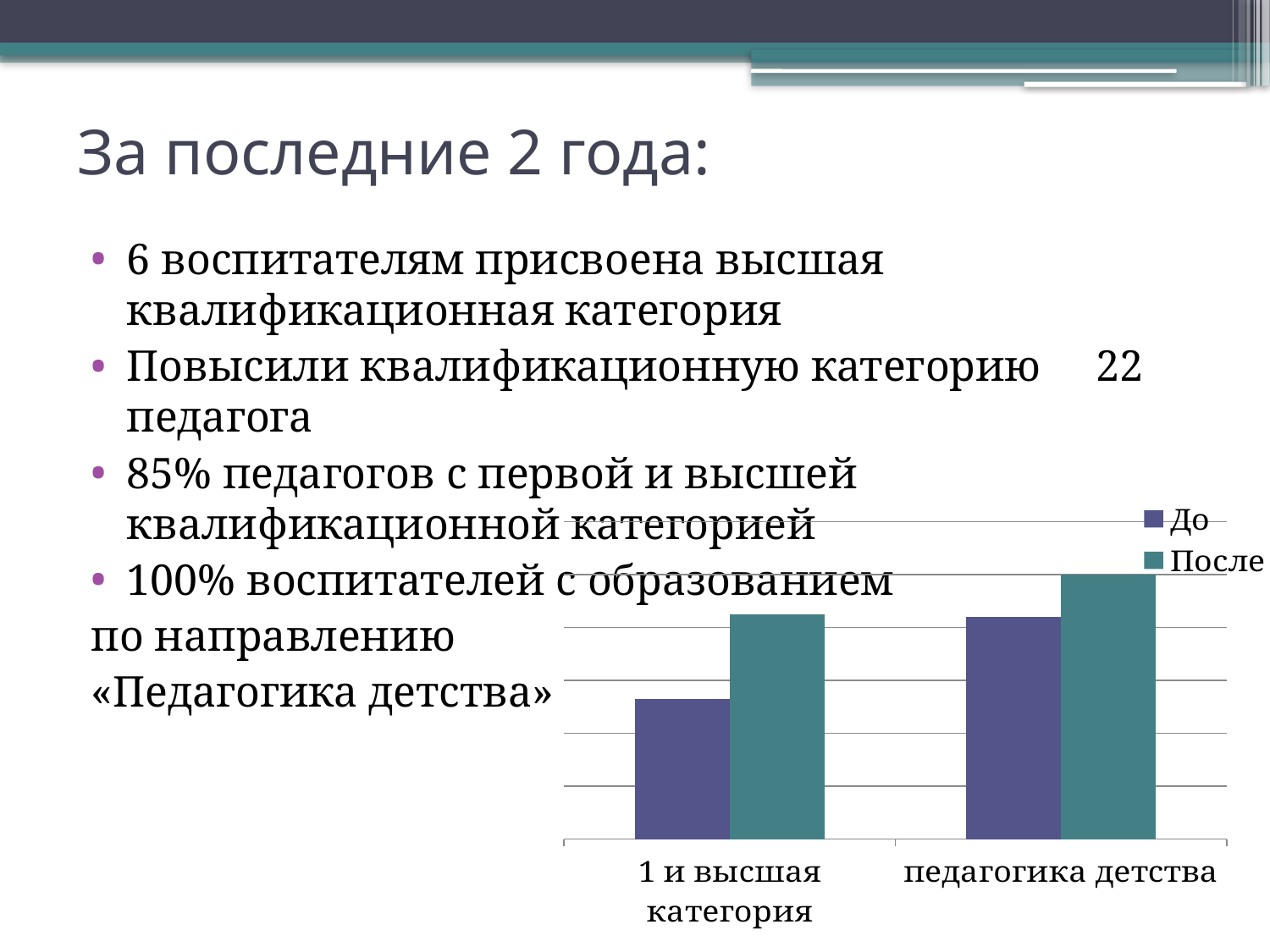
What are the two series named in the chart's legend? До, После Do the "До" values rise or fall from "1 и высшая категория" to "педагогика детства"? rise Which category has the lower "После" value? 1 и высшая категория Which category has the higher "До" value? педагогика детства Which is larger: the "После" value for "1 и высшая категория" or the "После" value for "педагогика детства"? педагогика детства For the category "педагогика детства", which is larger: "До" or "После"? После What kind of chart is shown on the slide? bar chart Which colour represents the series "После" in the chart? teal How many series does the chart's legend list? 2 Which bar is the tallest in the whole chart? После for педагогика детства For the category "1 и высшая категория", which is larger: "До" or "После"? После How many categories are shown on the x axis of the chart? 2